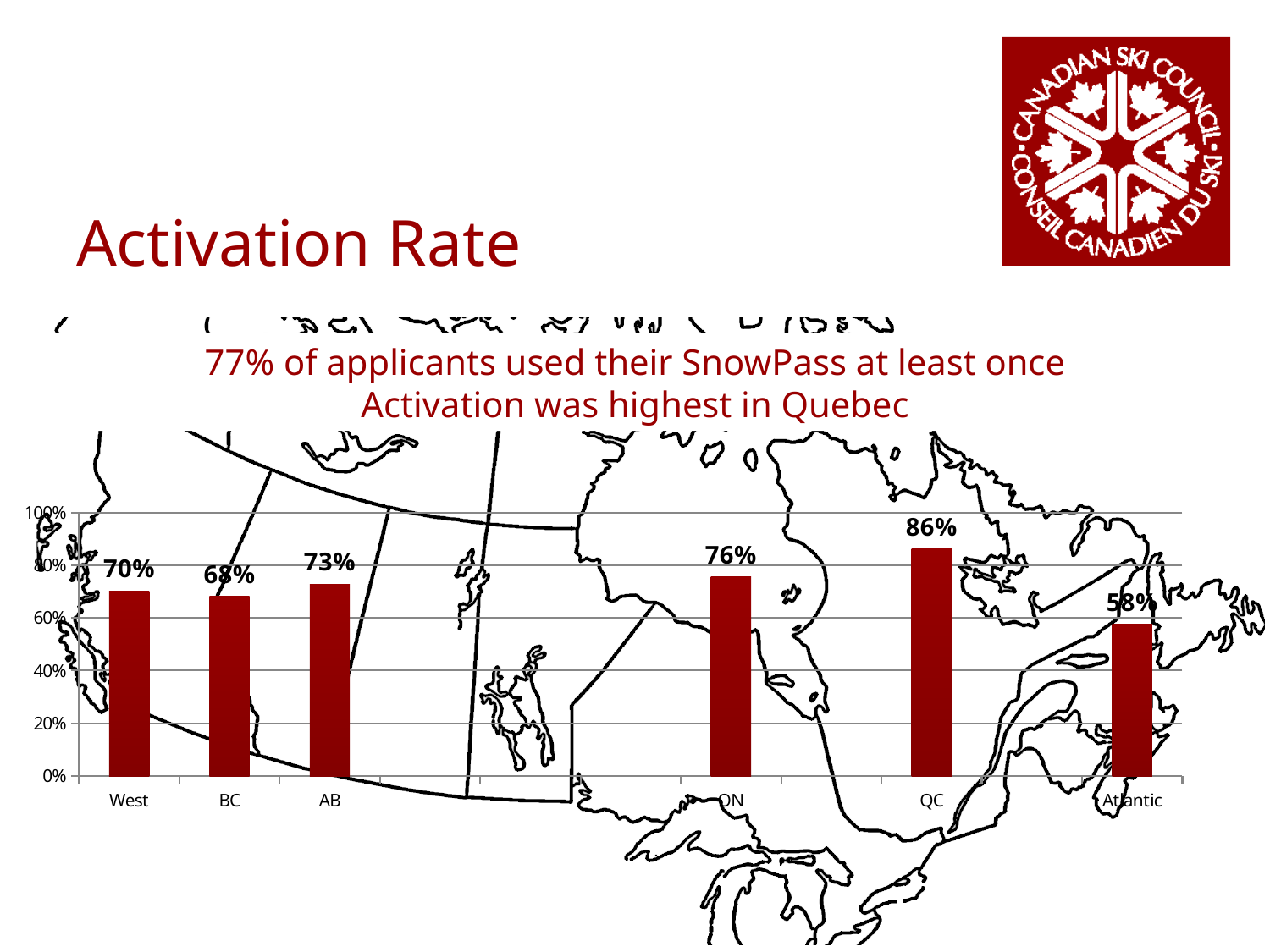
Which region has the highest activation rate? QC What is the activation rate for West? 70% What is the difference between the activation rates for QC and Atlantic? 28% What is the activation rate for ON? 76% Which has a higher activation rate, ON or AB? ON What is the activation rate for QC? 86% What is the activation rate for Atlantic? 58% How many regions are shown on the chart? 6 What kind of chart is shown on the slide? Bar chart Which region has the lowest activation rate? Atlantic What is the difference between the activation rates for AB and BC? 5% What is the title of the slide? Activation Rate